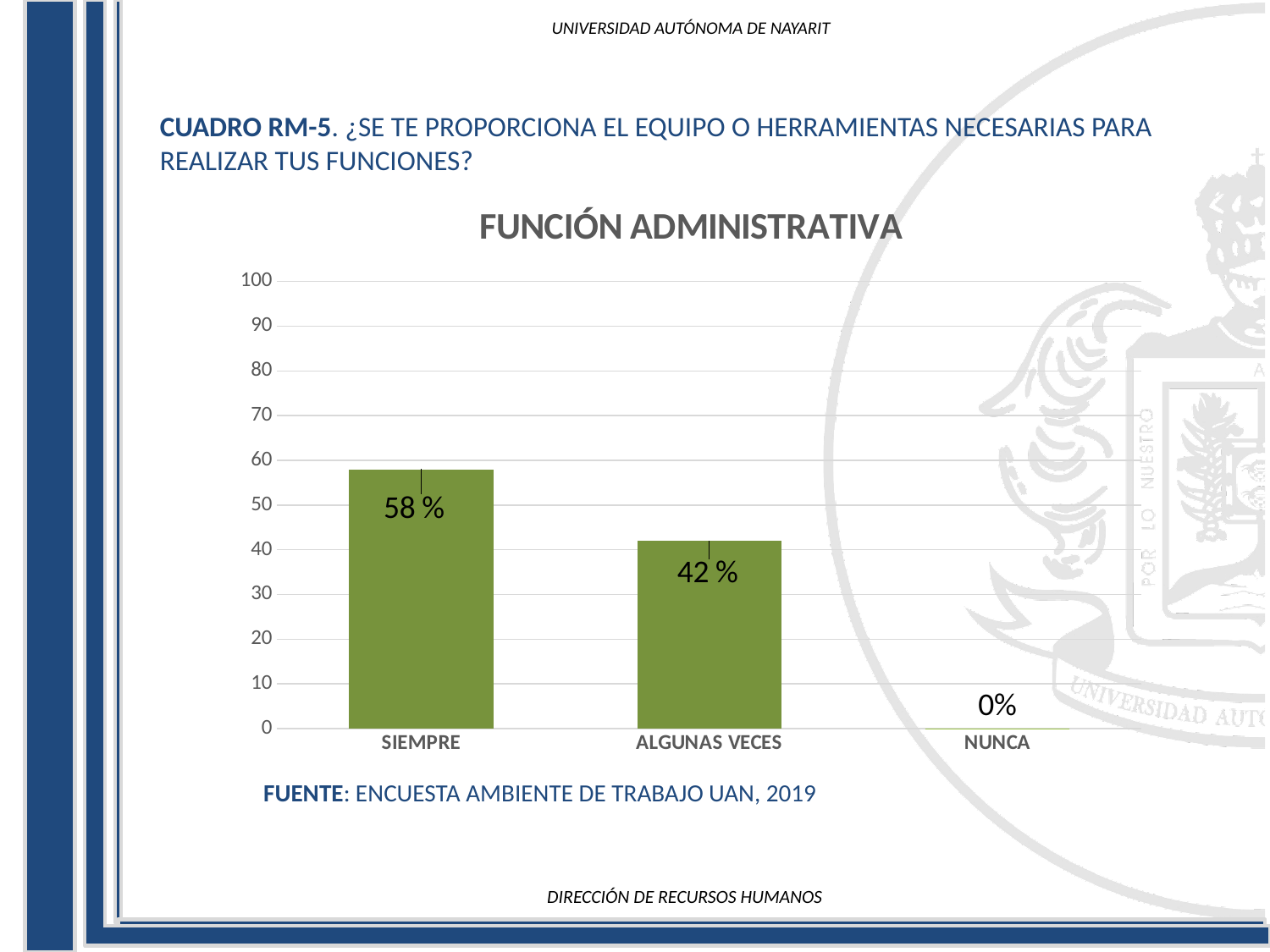
Which category has the highest value? SIEMPRE What is the value for NUNCA? 0% Do the values rise or fall from left to right along the x axis? fall What is the difference between the values for SIEMPRE and ALGUNAS VECES? 16 % Which category has the lowest value? NUNCA What is the title of the chart? FUNCIÓN ADMINISTRATIVA Which is larger, the value for SIEMPRE or the value for ALGUNAS VECES? SIEMPRE What is the value for SIEMPRE? 58 % What kind of chart is shown? bar chart Is the value for ALGUNAS VECES greater or less than 50? less What is the value for ALGUNAS VECES? 42 % How many categories are shown on the x axis? 3